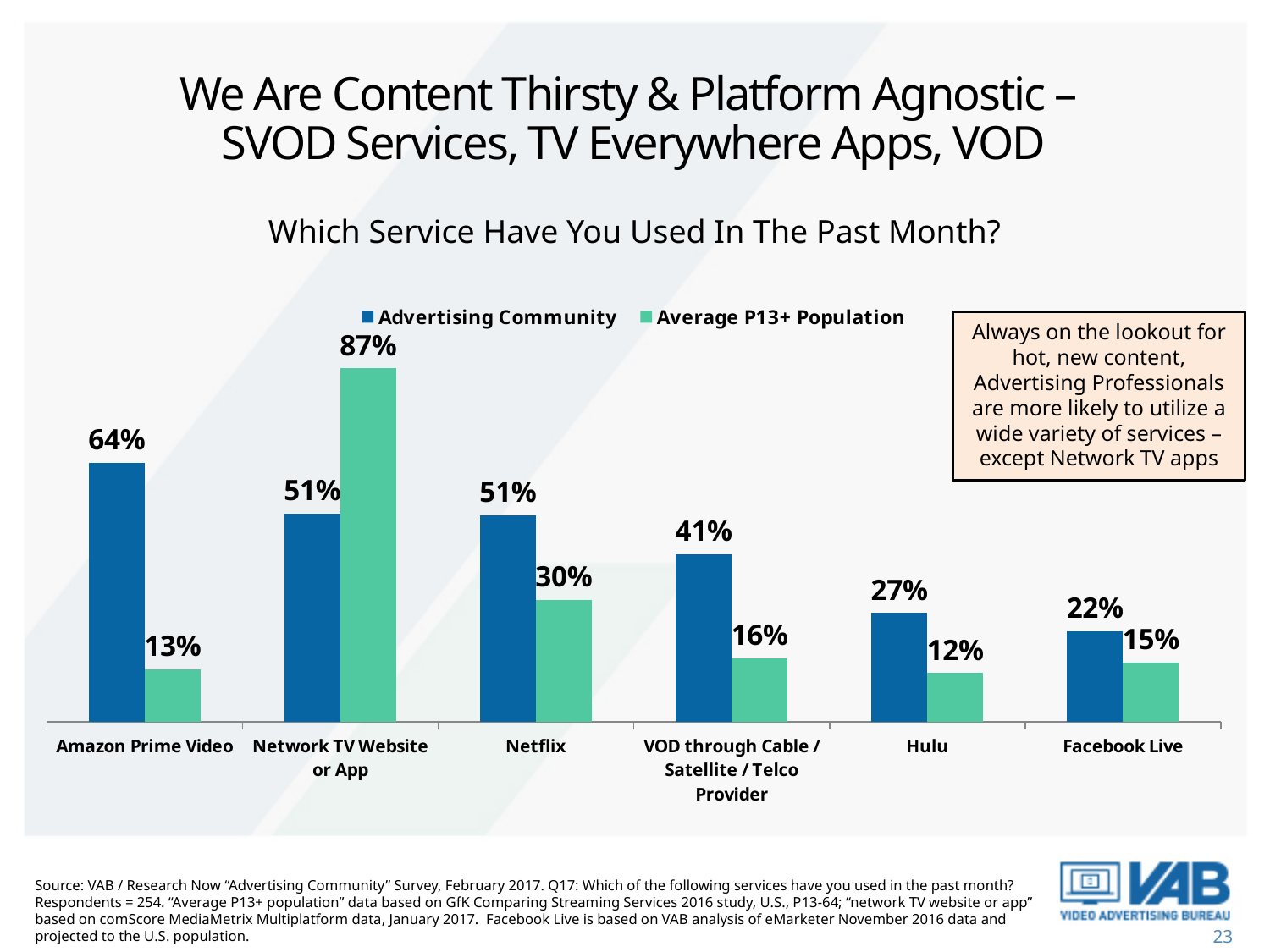
What is the difference between the Advertising Community and Average P13+ Population values for Netflix? 21% Which service has the lowest Average P13+ Population value? Hulu What kind of chart is shown on the slide? Bar chart What percentage of the Advertising Community used Amazon Prime Video in the past month? 64% Which service has the highest Advertising Community value? Amazon Prime Video What is the difference between the Advertising Community and Average P13+ Population values for Amazon Prime Video? 51% How many services are shown on the x axis of the chart? 6 What is the Average P13+ Population value for Hulu? 12% How many series does the chart legend list? 2 Which is larger for Network TV Website or App: the Advertising Community value or the Average P13+ Population value? Average P13+ Population What is the Average P13+ Population value for Network TV Website or App? 87% Which colour represents the Average P13+ Population series in the chart? Green